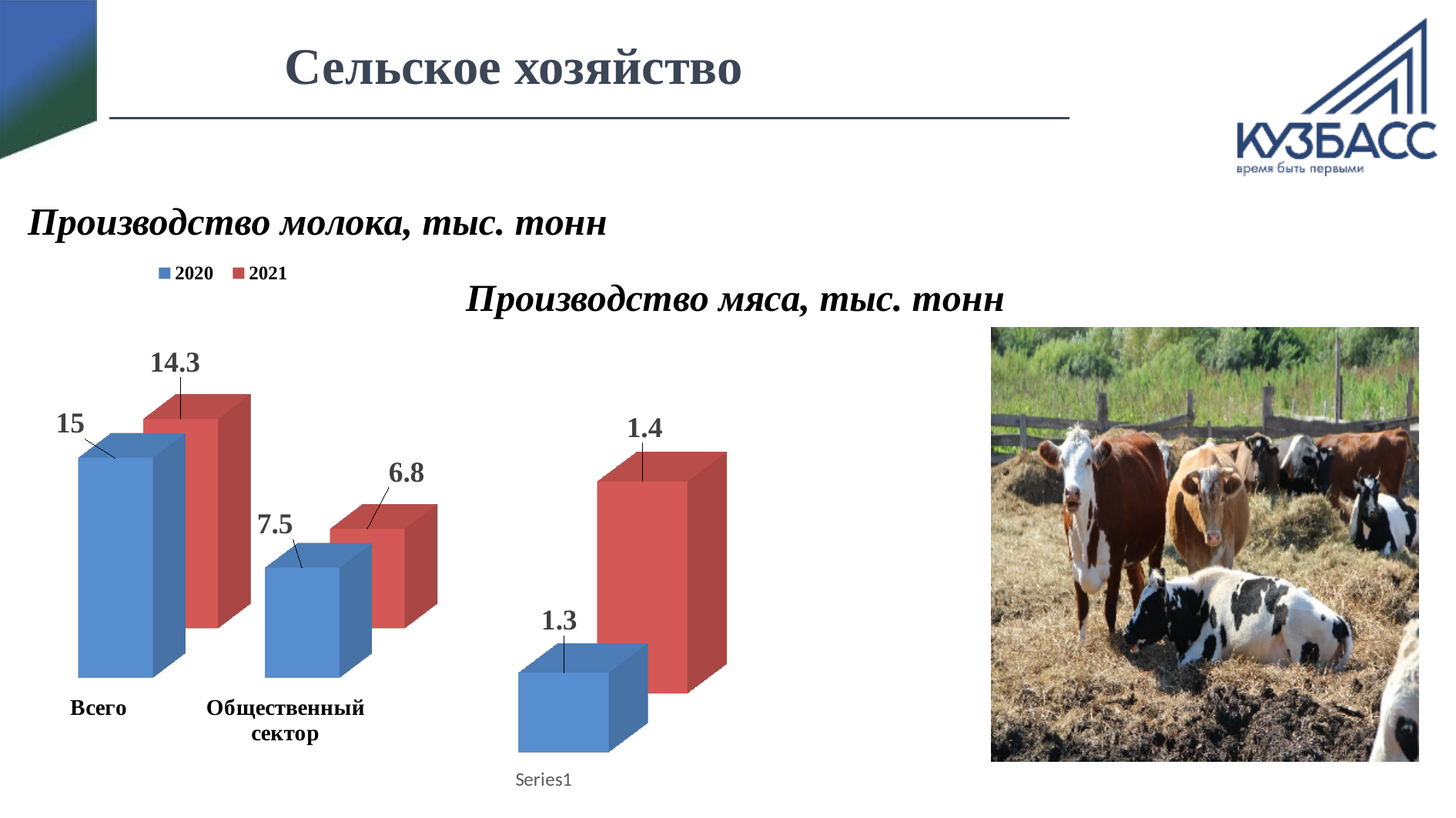
What kind of chart is the meat production chart (Производство мяса, тыс. тонн)? Bar chart In the milk production chart (Производство молока, тыс. тонн), what is the difference between the 2020 and 2021 values for Общественный сектор? 0.7 In the milk production chart (Производство молока, тыс. тонн), how many categories are shown on the x axis? 2 In the meat production chart (Производство мяса, тыс. тонн), what is the value of the red bar? 1.4 In the milk production chart (Производство молока, тыс. тонн), what is the value for Общественный сектор in 2020? 7.5 In the milk production chart (Производство молока, тыс. тонн), what is the value for Всего in 2021? 14.3 In the meat production chart (Производство мяса, тыс. тонн), what is the value of the blue bar? 1.3 In the milk production chart (Производство молока, тыс. тонн), what is the difference between the 2020 and 2021 values for Всего? 0.7 In the milk production chart (Производство молока, тыс. тонн), what is the value for Общественный сектор in 2021? 6.8 In the milk production chart (Производство молока, тыс. тонн), which year has the larger value for Общественный сектор, 2020 or 2021? 2020 In the milk production chart (Производство молока, тыс. тонн), what is the value for Всего in 2020? 15 In the milk production chart (Производство молока, тыс. тонн), how many series does the legend list? 2